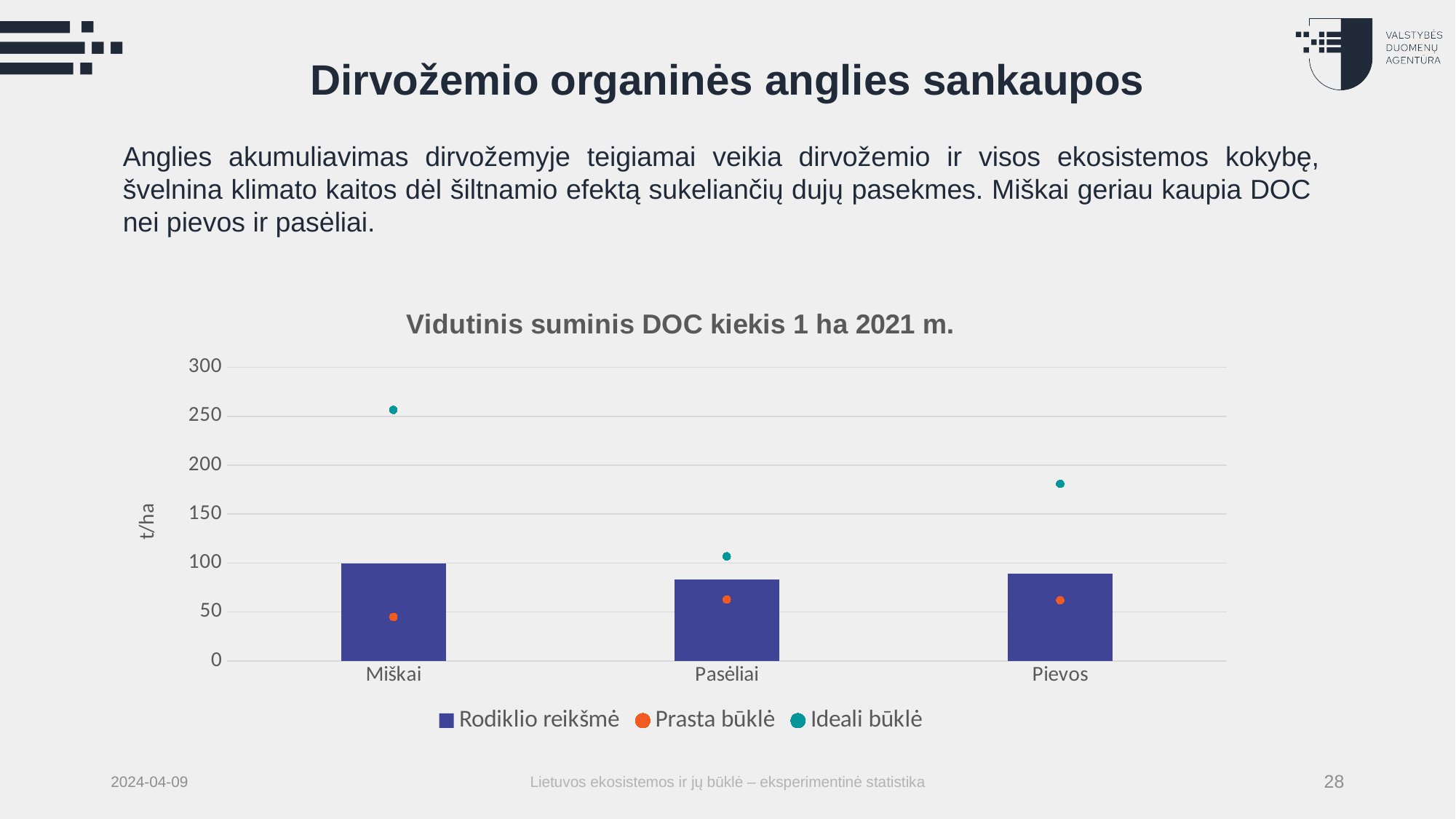
How many series does the chart legend list? 3 Is the Prasta būklė value for Miškai greater or less than 50? less Is the Ideali būklė value for Miškai greater or less than 250? greater What kind of chart is shown on the slide? bar chart Is the Rodiklio reikšmė value for Pasėliai greater or less than 100? less What unit is shown on the y axis of the chart? t/ha Which category has the highest Ideali būklė value? Miškai How many categories are shown on the x axis of the chart? 3 Which is larger, the Ideali būklė value for Pievos or for Pasėliai? Pievos Which category has the lowest Ideali būklė value? Pasėliai Which category has the highest Rodiklio reikšmė bar? Miškai